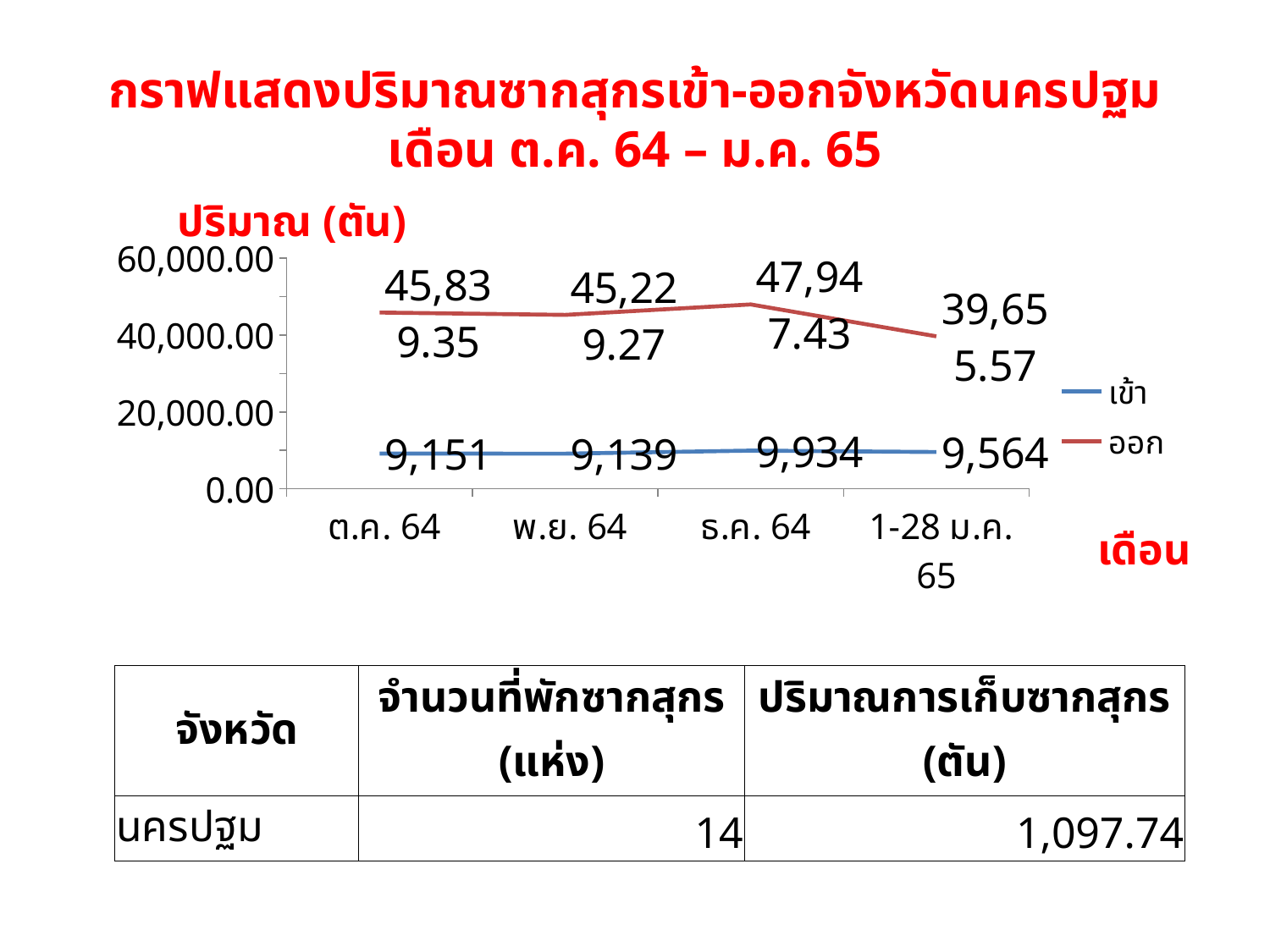
What type of chart is shown on the slide? line chart What is the value of ออก for ธ.ค. 64? 47,947.43 Which is larger in ต.ค. 64, the เข้า value or the ออก value? ออก How many series does the legend list? 2 How many months (categories) are plotted on the x axis? 4 In which month is the ออก value lowest? 1-28 ม.ค. 65 What is the label on the vertical axis of the chart? ปริมาณ (ตัน) What is the value of เข้า for ธ.ค. 64? 9,934 What is the difference between the ออก values for ธ.ค. 64 and ต.ค. 64? 2,108.08 Is the value for เข้า in พ.ย. 64 greater or less than 20,000.00? less What is the value of ออก for 1-28 ม.ค. 65? 39,655.57 In which month is the ออก value highest? ธ.ค. 64